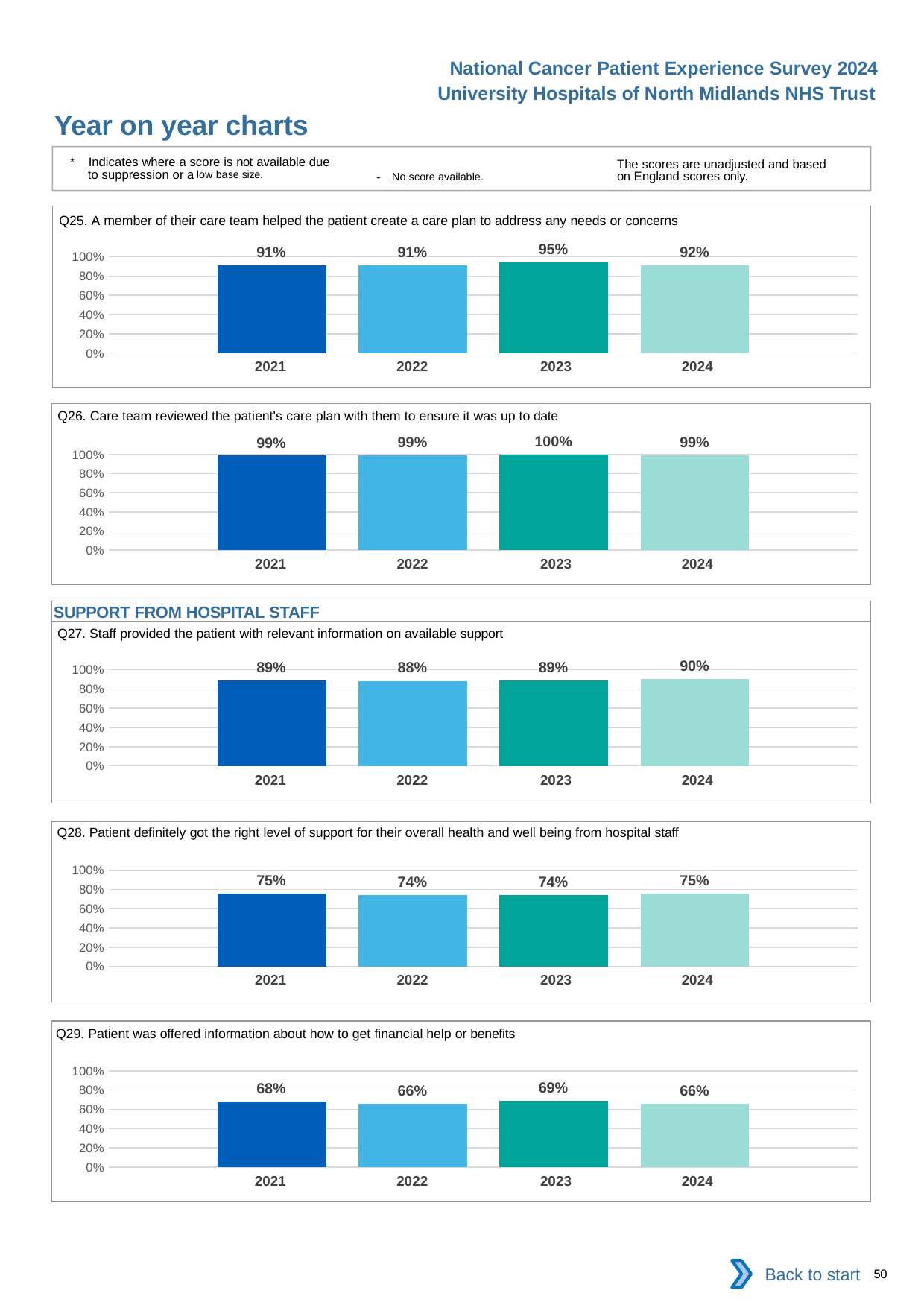
In the Q25 chart, what is the value for 2023? 95% In the Q27 chart, which year has the lowest value? 2022 In the Q28 chart, is the value for 2023 greater or less than 80%? less In the Q25 chart, which year has the highest value? 2023 How many years are shown in the Q29 chart? 4 What type of chart is the Q25 chart? bar chart In the Q27 chart, what is the value for 2022? 88% In the Q29 chart, what is the value for 2023? 69% In the Q26 chart, which year has the highest value? 2023 In the Q28 chart, what is the difference between the 2021 value and the 2022 value? 1% In the Q29 chart, which is larger, the value for 2021 or the value for 2022? 2021 In the Q26 chart, what is the value for 2024? 99%